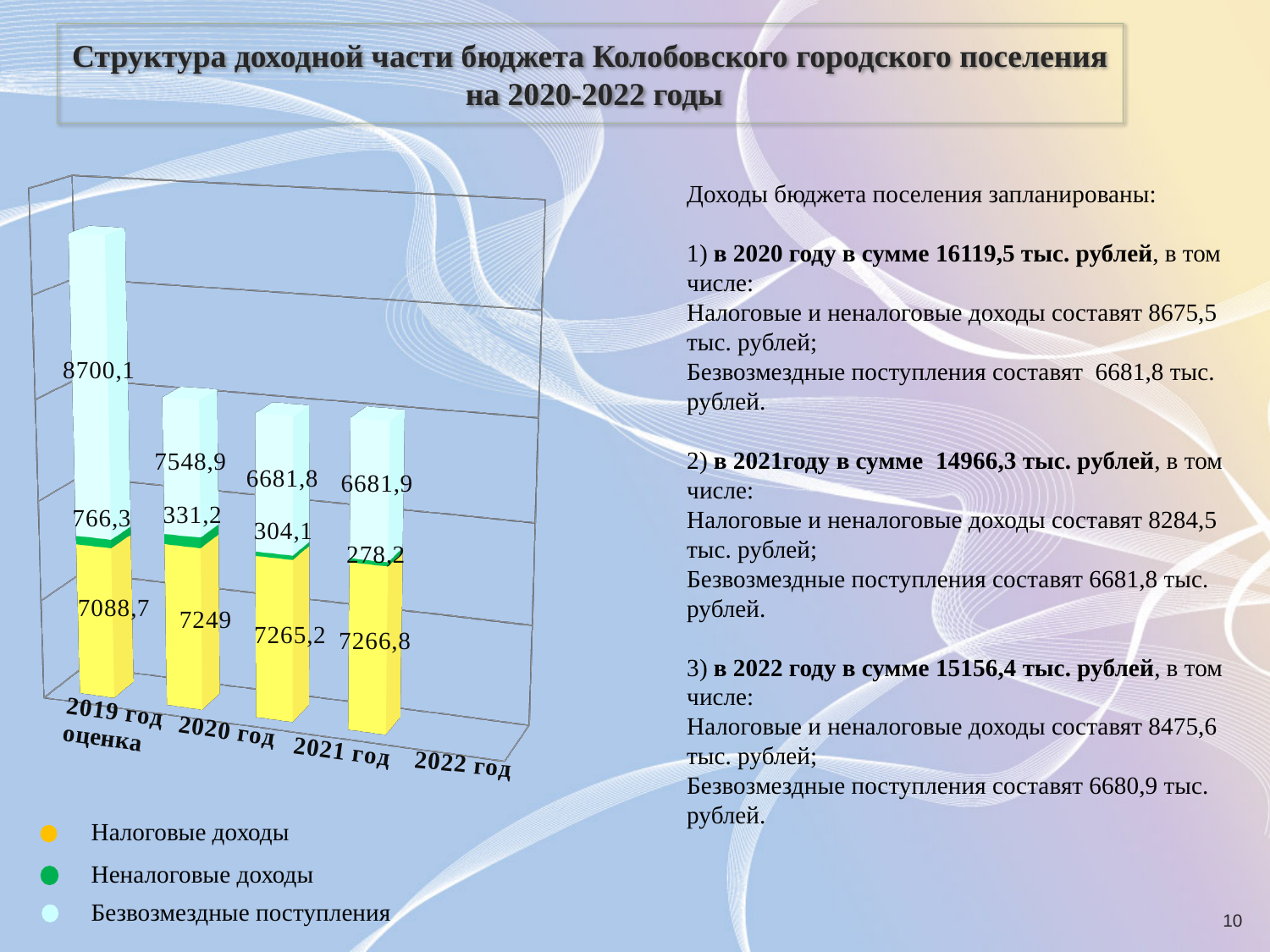
What is the value of Безвозмездные поступления for 2022 год? 6681,9 How many series does the legend list? 3 In which year is Неналоговые доходы the lowest? 2022 год How many years (categories) are shown on the x axis? 4 Do the values of Неналоговые доходы rise or fall from 2019 to 2022? fall What is the value of Налоговые доходы for 2020 год? 7249 Which is larger: Налоговые доходы in 2019 год оценка or in 2020 год? 2020 год What kind of chart is shown on the slide? stacked bar chart What is the difference between Безвозмездные поступления in 2019 год оценка and 2020 год? 1151,2 What is the value of Безвозмездные поступления for 2019 год оценка? 8700,1 What is the value of Неналоговые доходы for 2021 год? 304,1 In which year is Безвозмездные поступления the highest? 2019 год оценка